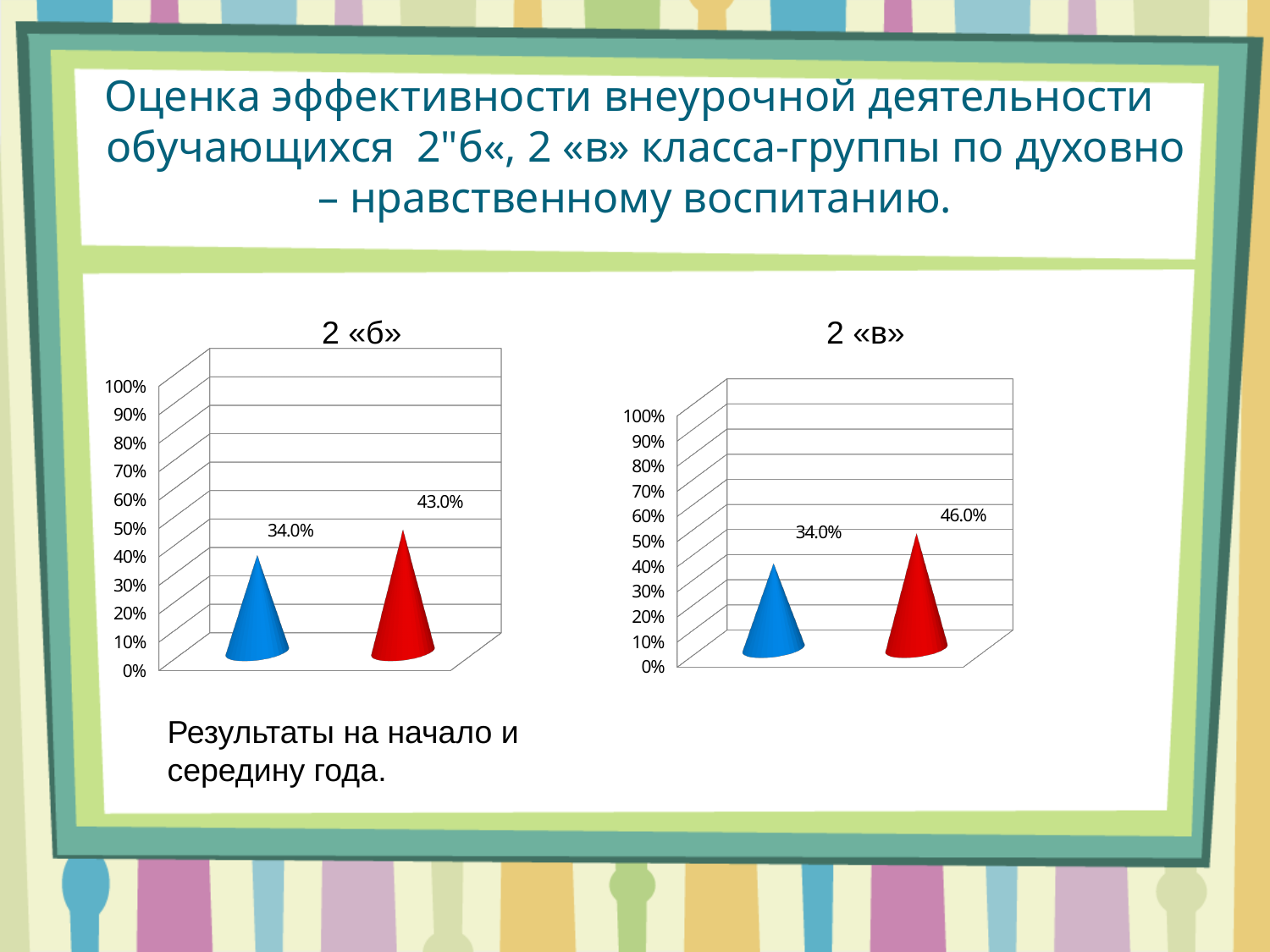
In the chart titled 2 «в», is the value of the red bar greater or less than 50%? less In the chart titled 2 «в», which bar has the lowest value? the blue bar In the chart titled 2 «б», what is the difference between the red bar's value and the blue bar's value? 9.0% In the chart titled 2 «в», what is the difference between the red bar's value and the blue bar's value? 12.0% What is the title of the chart on the right side of the slide? 2 «в» In the chart titled 2 «б», what value is shown for the red bar? 43.0% How many bars are plotted in the chart titled 2 «б»? 2 In the chart titled 2 «в», what value is shown for the red bar? 46.0% What kind of chart is the chart titled 2 «в»? bar chart In the chart titled 2 «в», what value is shown for the blue bar? 34.0% In the chart titled 2 «б», what value is shown for the blue bar? 34.0% In the chart titled 2 «б», which bar has the higher value, the blue one or the red one? the red one